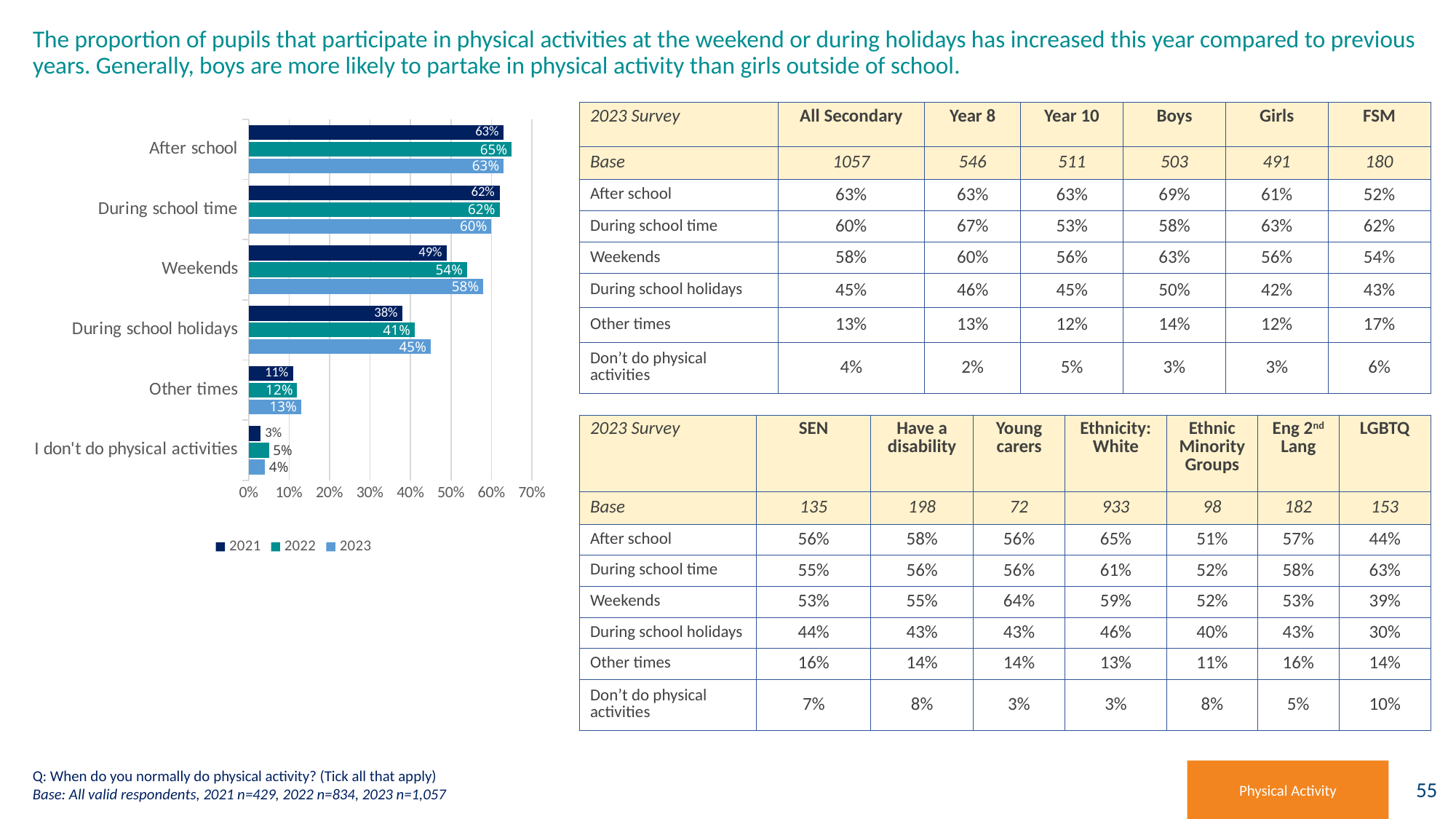
In the bar chart, do the values for During school holidays rise or fall from 2021 to 2023? rise What is the 2021 value for During school holidays in the bar chart? 38% Which category has the lowest 2022 value in the bar chart? I don't do physical activities What kind of chart is shown on the slide? bar chart How many categories are shown in the bar chart? 6 In the bar chart, is the 2022 value for During school holidays larger or smaller than the 2023 value? smaller What is the 2022 value for After school in the bar chart? 65% Which category has the highest 2023 value in the bar chart? After school What is the difference between the 2023 and 2021 values for Weekends in the bar chart? 9% What are the series listed in the legend of the bar chart? 2021, 2022, 2023 How many series does the legend of the bar chart list? 3 What is the 2023 value for Weekends in the bar chart? 58%